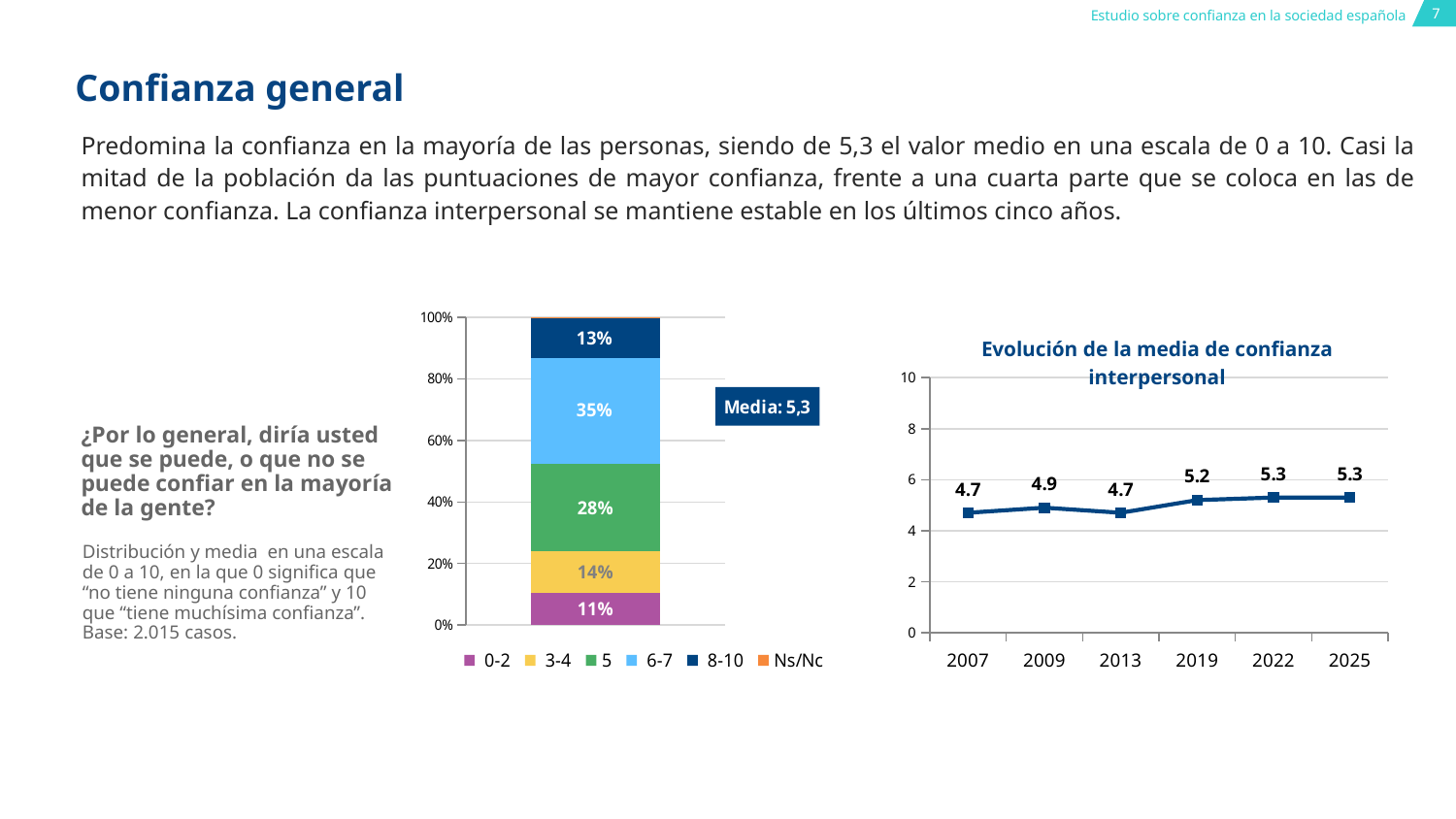
How many years are plotted in the chart titled 'Evolución de la media de confianza interpersonal'? 6 In the stacked bar chart on the left, which segment has the largest percentage? 6-7 In the stacked bar chart on the left, what is the difference between the 5 segment and the 3-4 segment? 14% In the chart titled 'Evolución de la media de confianza interpersonal', what is the value for 2019? 5.2 In the stacked bar chart on the left, what percentage is shown for the 6-7 segment? 35% In the chart titled 'Evolución de la media de confianza interpersonal', what is the value for 2009? 4.9 In the chart titled 'Evolución de la media de confianza interpersonal', do the values generally rise or fall from 2013 to 2025? Rise In the stacked bar chart on the left, what percentage is shown for the 0-2 segment? 11% What kind of chart is the one titled 'Evolución de la media de confianza interpersonal'? Line chart In the chart titled 'Evolución de la media de confianza interpersonal', what is the difference between the 2025 value and the 2007 value? 0.6 How many entries does the legend of the stacked bar chart on the left list? 6 In the stacked bar chart on the left, which is larger, the 8-10 segment or the 3-4 segment? 3-4